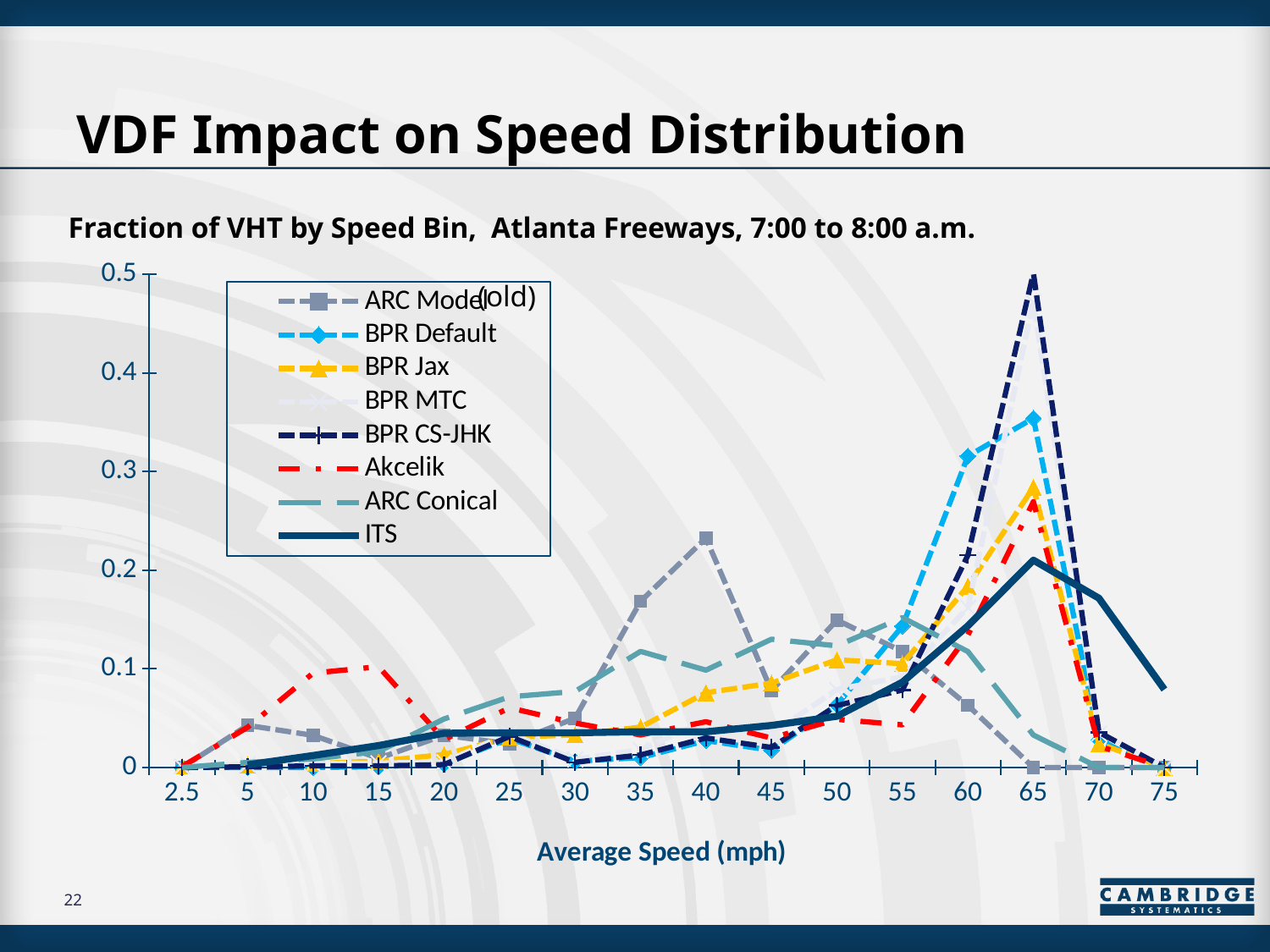
How many series does the legend list? 8 Is the value for BPR CS-JHK at 65 mph greater or less than 0.4? greater At 60 mph, which series has the larger value, BPR Default or ITS? BPR Default Which series reaches the highest value anywhere on the chart? BPR CS-JHK How many speed bins are shown along the x axis? 16 Is the value for ITS at 70 mph greater or less than 0.1? greater Is the value for BPR Default at 65 mph greater or less than 0.3? greater At which average speed does the BPR CS-JHK series reach its peak? 65 At 65 mph, which series has the larger value, BPR CS-JHK or BPR Default? BPR CS-JHK What kind of chart is shown on the slide? Line chart What is the label of the x axis? Average Speed (mph)